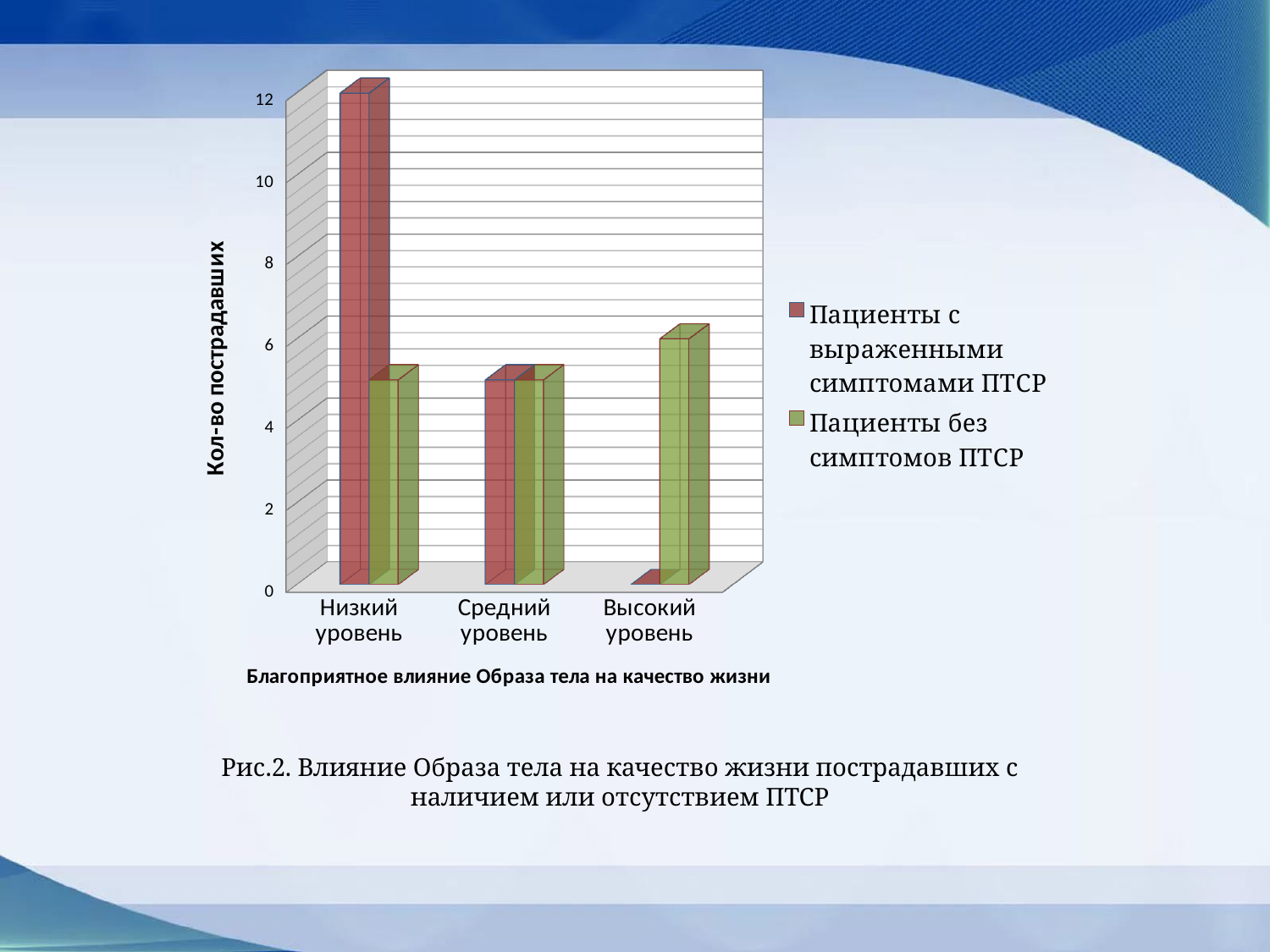
How many categories are shown on the x axis? 3 At 'Низкий уровень', which series has the larger value? Пациенты с выраженными симптомами ПТСР What kind of chart is shown on the slide? bar chart Is the value for 'Пациенты без симптомов ПТСР' at 'Высокий уровень' greater or less than 4? greater For the series 'Пациенты без симптомов ПТСР', which category has the highest value? Высокий уровень For the series 'Пациенты с выраженными симптомами ПТСР', which category has the highest value? Низкий уровень For the series 'Пациенты с выраженными симптомами ПТСР', which category has the lowest value? Высокий уровень Is the value for 'Пациенты с выраженными симптомами ПТСР' at 'Низкий уровень' greater or less than 10? greater Is the value for 'Пациенты с выраженными симптомами ПТСР' at 'Высокий уровень' greater or less than 2? less Do the values for 'Пациенты с выраженными симптомами ПТСР' rise or fall from 'Низкий уровень' to 'Высокий уровень'? fall At 'Высокий уровень', which series has the larger value? Пациенты без симптомов ПТСР How many series does the legend list? 2